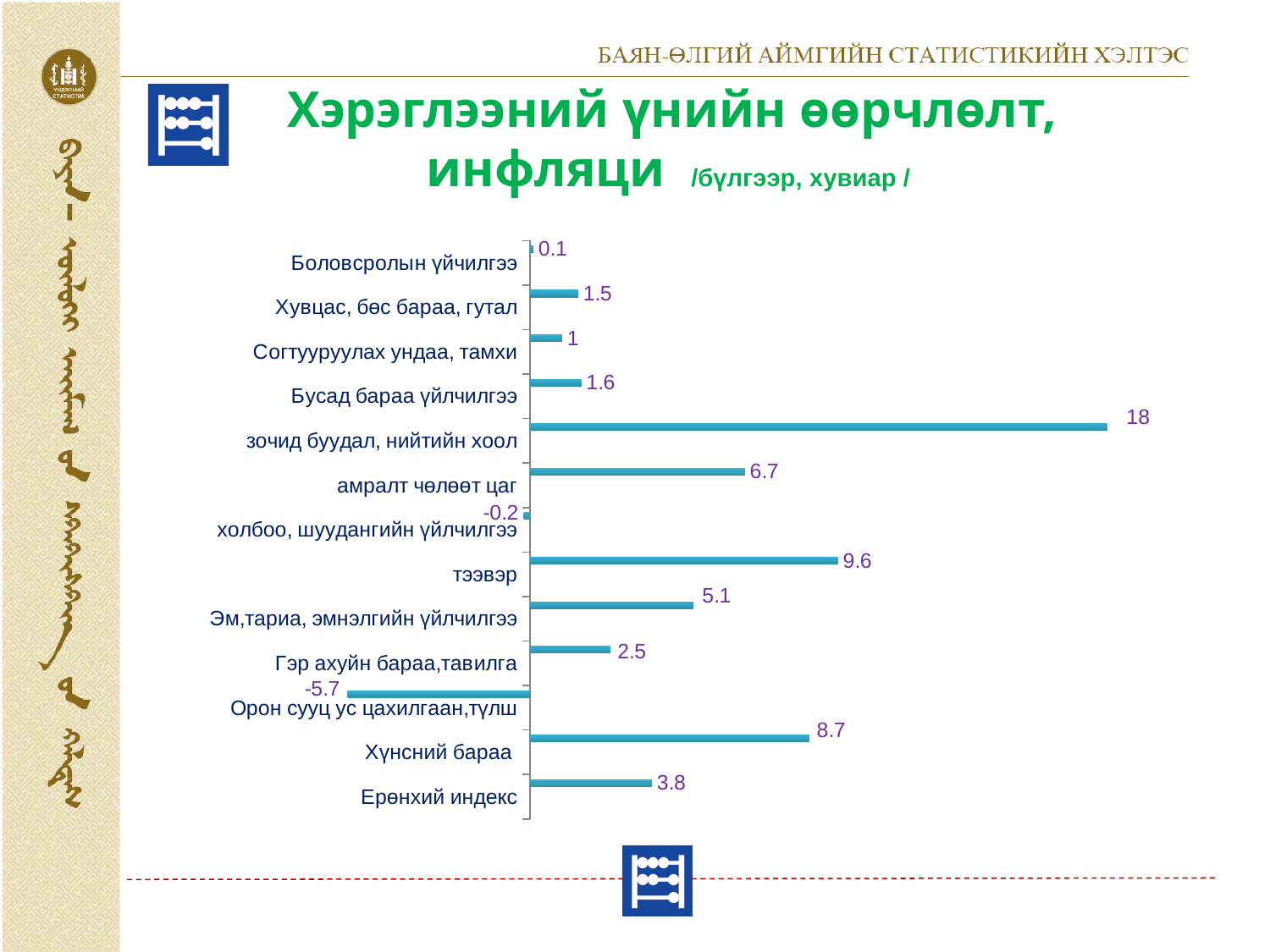
What is the value for холбоо, шуудангийн үйлчилгээ? -0.2 Which category has the lowest value? Орон сууц ус цахилгаан,түлш What is the value for Ерөнхий индекс? 3.8 What kind of chart is shown on the slide? Bar chart What is the value for тээвэр? 9.6 What is the value for Хүнсний бараа? 8.7 What is the value for Орон сууц ус цахилгаан,түлш? -5.7 How many categories are plotted in the chart? 13 Which is larger, the value for амралт чөлөөт цаг or the value for Эм,тариа, эмнэлгийн үйлчилгээ? амралт чөлөөт цаг Which category has the highest value? зочид буудал, нийтийн хоол What is the difference between the values for тээвэр and Хүнсний бараа? 0.9 What is the title of the chart on the slide? Хэрэглээний үнийн өөрчлөлт, инфляци /бүлгээр, хувиар /